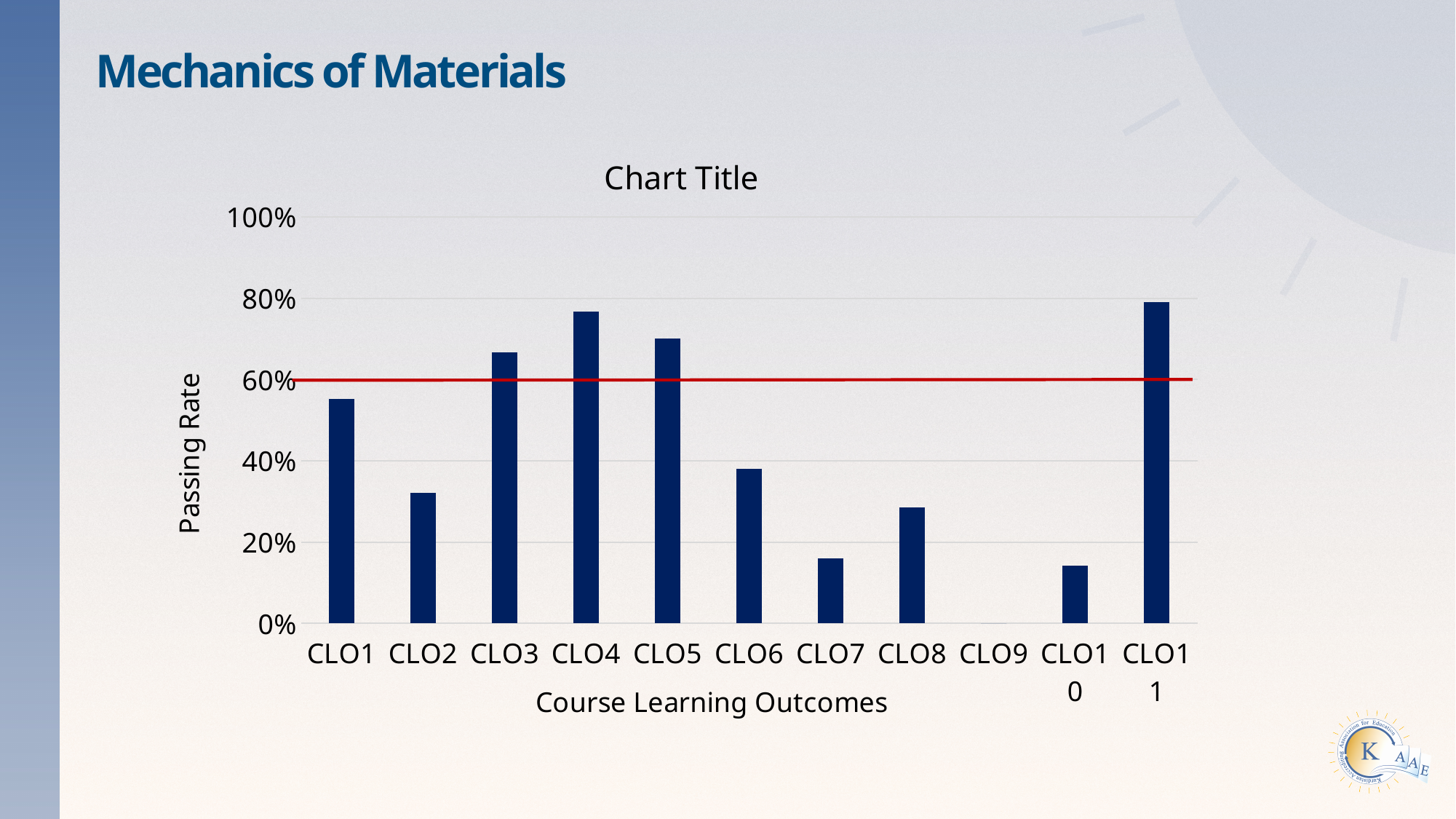
Is the passing rate for CLO1 greater or less than 60%? less Which has the higher passing rate, CLO5 or CLO6? CLO5 How many course learning outcomes (categories) are plotted on the x axis? 11 Is the passing rate for CLO2 greater or less than 20%? greater What is the label on the vertical axis of the chart? Passing Rate Which has the higher passing rate, CLO3 or CLO2? CLO3 Is the passing rate for CLO4 greater or less than 60%? greater Which course learning outcome has the lowest passing rate? CLO9 What kind of chart is shown on the slide? bar chart At what value on the vertical axis is the red horizontal line drawn? 60%